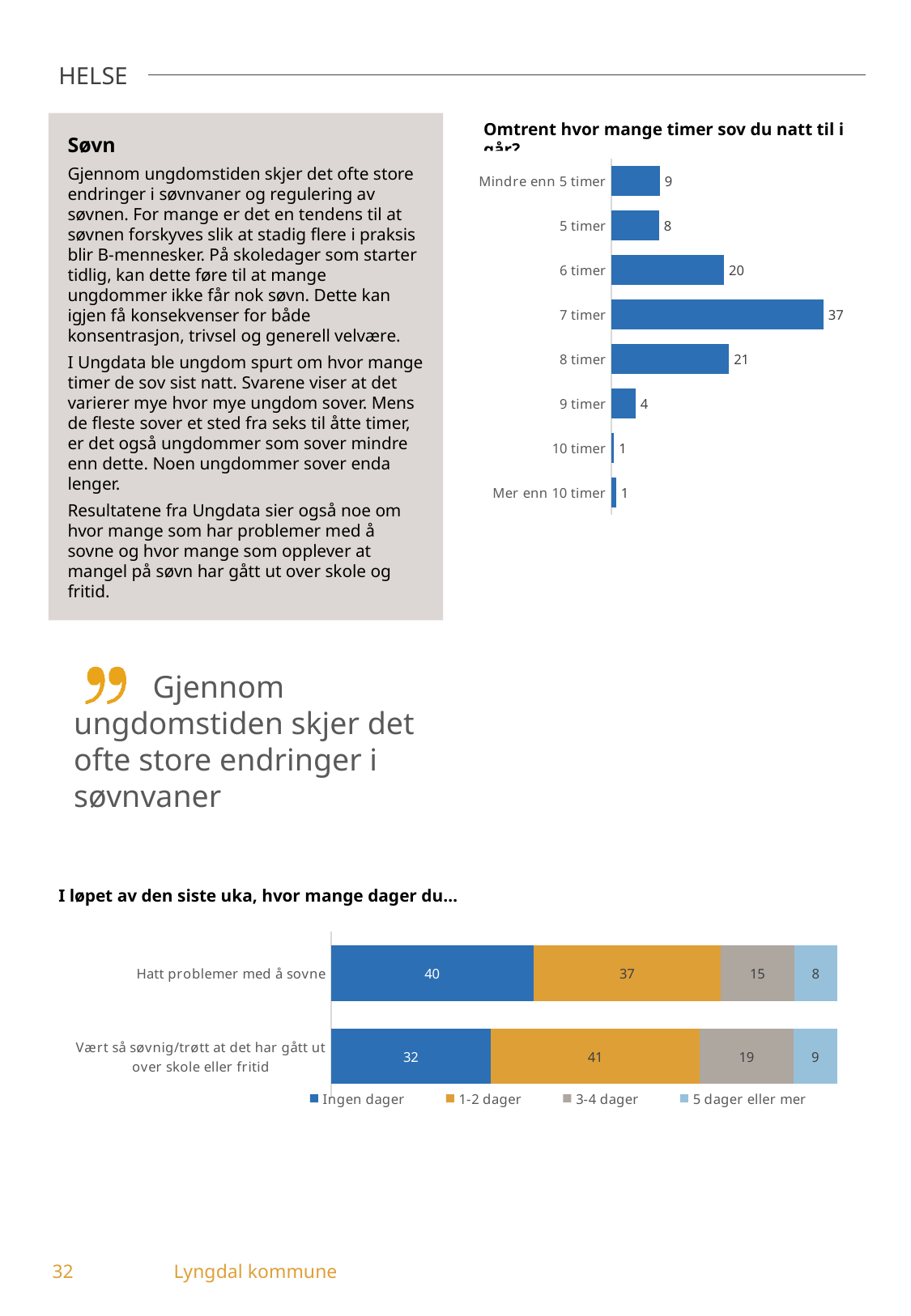
In the top-right chart (Omtrent hvor mange timer sov du natt til i går?), which is larger: the value for Mindre enn 5 timer or the value for 5 timer? Mindre enn 5 timer How many series does the legend list in the bottom chart (I løpet av den siste uka, hvor mange dager du…)? 4 In the bottom chart (I løpet av den siste uka, hvor mange dager du…), what is the total of the stacked bar for 'Vært så søvnig/trøtt at det har gått ut over skole eller fritid'? 101 In the bottom chart (I løpet av den siste uka, hvor mange dager du…), which colour represents the series '1-2 dager'? Orange In the top-right chart (Omtrent hvor mange timer sov du natt til i går?), what is the value for 7 timer? 37 In the top-right chart (Omtrent hvor mange timer sov du natt til i går?), what is the value for 6 timer? 20 In the top-right chart (Omtrent hvor mange timer sov du natt til i går?), which category has the highest value? 7 timer In the bottom chart (I løpet av den siste uka, hvor mange dager du…), what is the value for 3-4 dager for 'Vært så søvnig/trøtt at det har gått ut over skole eller fritid'? 19 How many categories are shown in the top-right chart (Omtrent hvor mange timer sov du natt til i går?)? 8 In the bottom chart (I løpet av den siste uka, hvor mange dager du…), what is the value for Ingen dager for 'Hatt problemer med å sovne'? 40 What kind of chart is the top-right chart (Omtrent hvor mange timer sov du natt til i går?)? Bar chart In the top-right chart (Omtrent hvor mange timer sov du natt til i går?), what is the difference between the values for 8 timer and 6 timer? 1